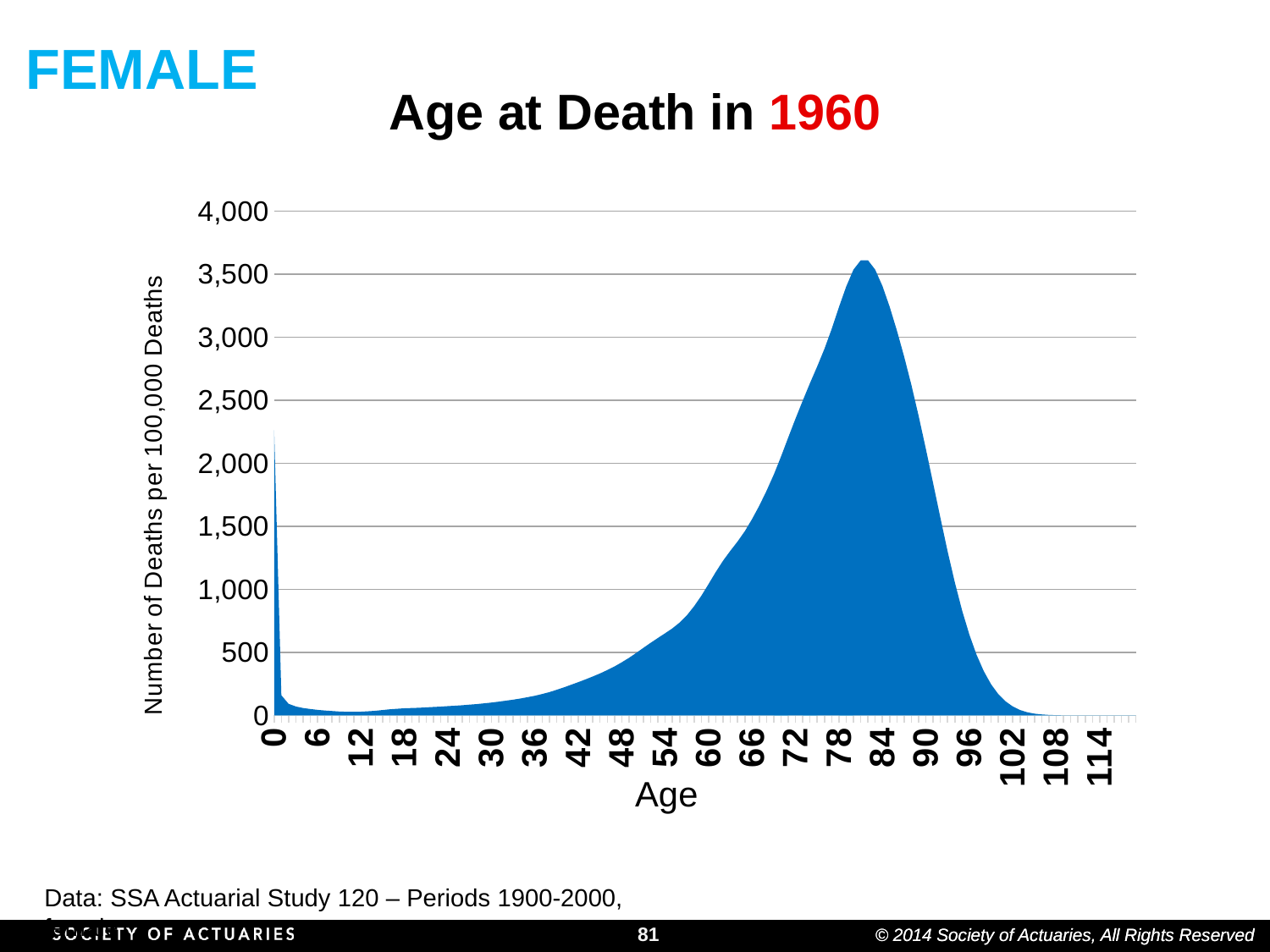
What is the title of the chart? Age at Death in 1960 Is the peak value of the chart greater or less than 3,500? greater Is the value at age 0 greater or less than 2,000? greater What is the label of the vertical axis? Number of Deaths per 100,000 Deaths Do the values rise or fall as age increases from 30 to 78? rise Between which two labeled ages on the x axis does the peak of the chart occur? 78 and 84 Is the value at age 54 greater or less than 1,000? less What kind of chart is shown on the slide? area chart